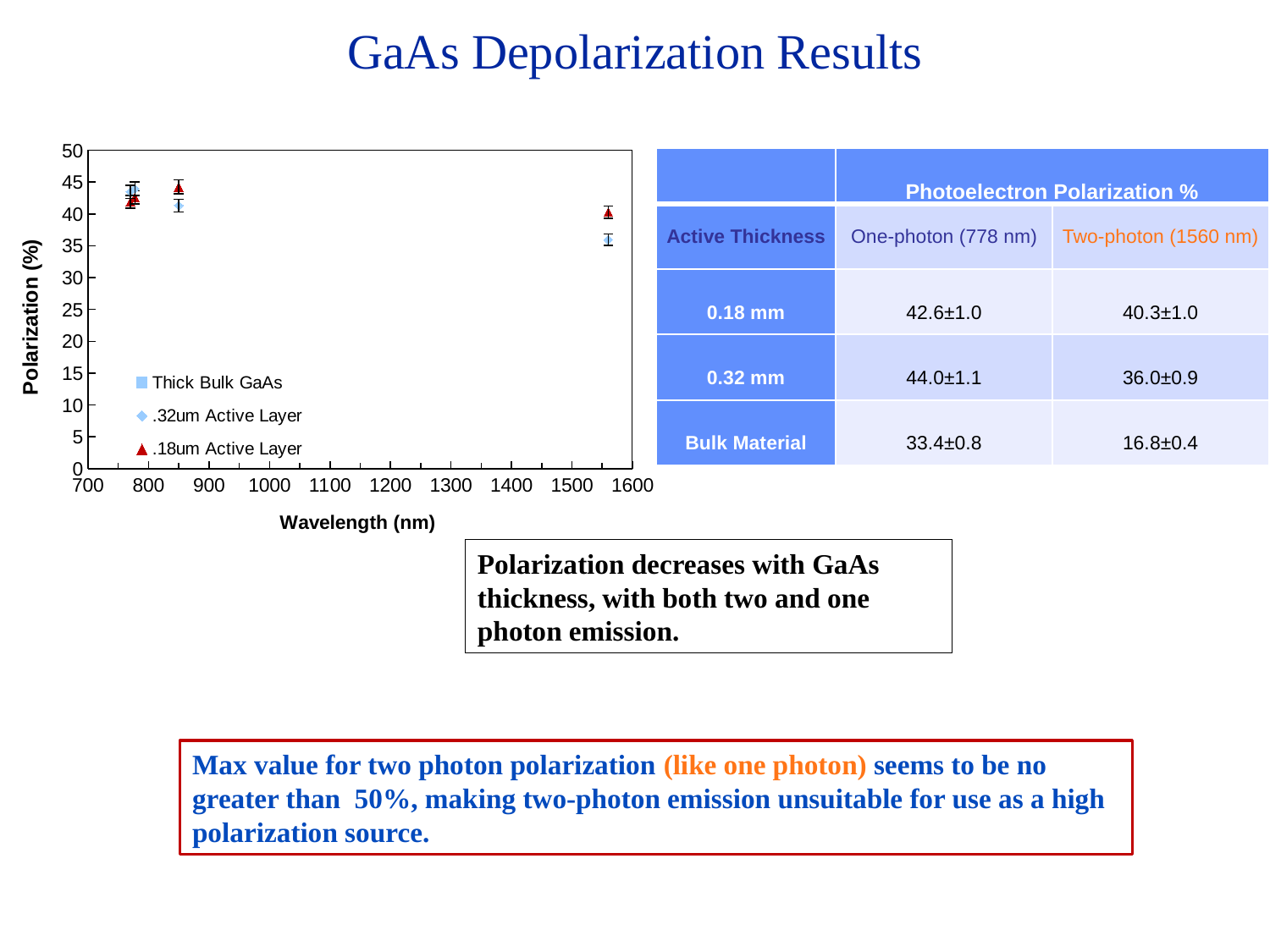
Is the value for the .18um Active Layer at about 850 nm greater or less than 40? greater What kind of chart is shown on the slide? scatter chart Do the values for the .32um Active Layer rise or fall as wavelength increases from 800 nm to 1600 nm? fall What is the title of the chart's x axis? Wavelength (nm) How many series does the chart legend list? 3 Is the value for the .32um Active Layer at about 850 nm greater or less than 35? greater Is the value for the .18um Active Layer at about 1560 nm greater or less than 30? greater At about 1560 nm, which series has the larger value: .18um Active Layer or .32um Active Layer? .18um Active Layer What is the highest value shown on the chart's y axis? 50 What is the title of the chart's y axis? Polarization (%)